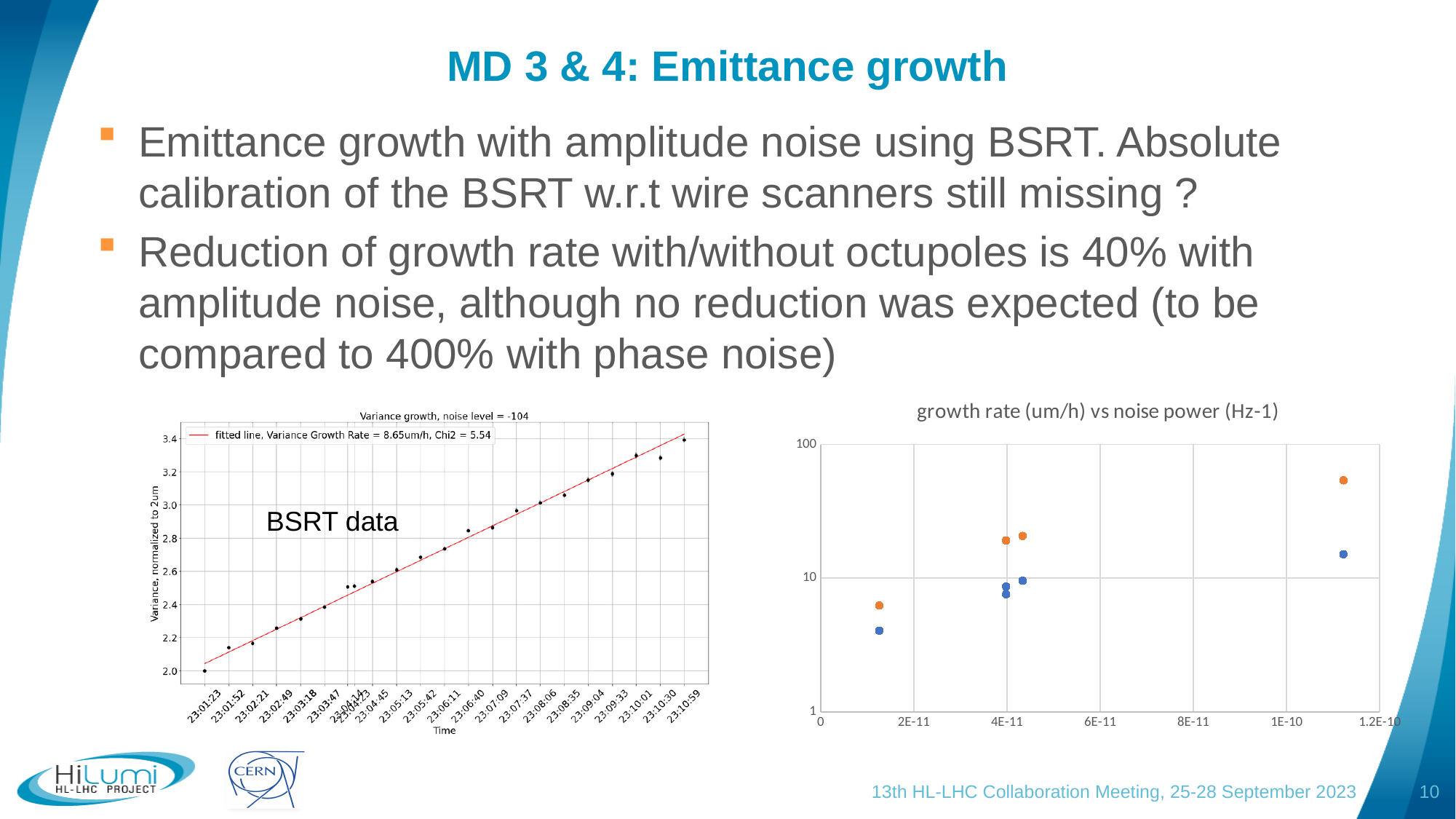
In the left chart (Variance growth), what is the variance value of the first point at 23:01:23? 2.0 What kind of chart is the right-hand chart titled 'growth rate (um/h) vs noise power (Hz-1)'? scatter chart In the left chart (Variance growth), is the value at 23:02:21 greater or less than 2.4? less What is the title of the chart on the left of the slide? Variance growth, noise level = -104 In the right chart (growth rate vs noise power), which colour series contains the highest plotted point? orange In the left chart (Variance growth), do the plotted values rise or fall along the time axis? rise In the left chart (Variance growth), is the value at 23:10:01 greater or less than 3.2? greater In the left chart (Variance growth), what Variance Growth Rate does the legend give for the fitted line? 8.65um/h In the right chart (growth rate vs noise power), is the blue point at the lowest noise power (about 1.3E-11) greater or less than 10? less In the right chart (growth rate vs noise power), at the highest noise power, which is larger: the orange point or the blue point? orange In the right chart (growth rate vs noise power), do the growth rates rise or fall as noise power increases? rise